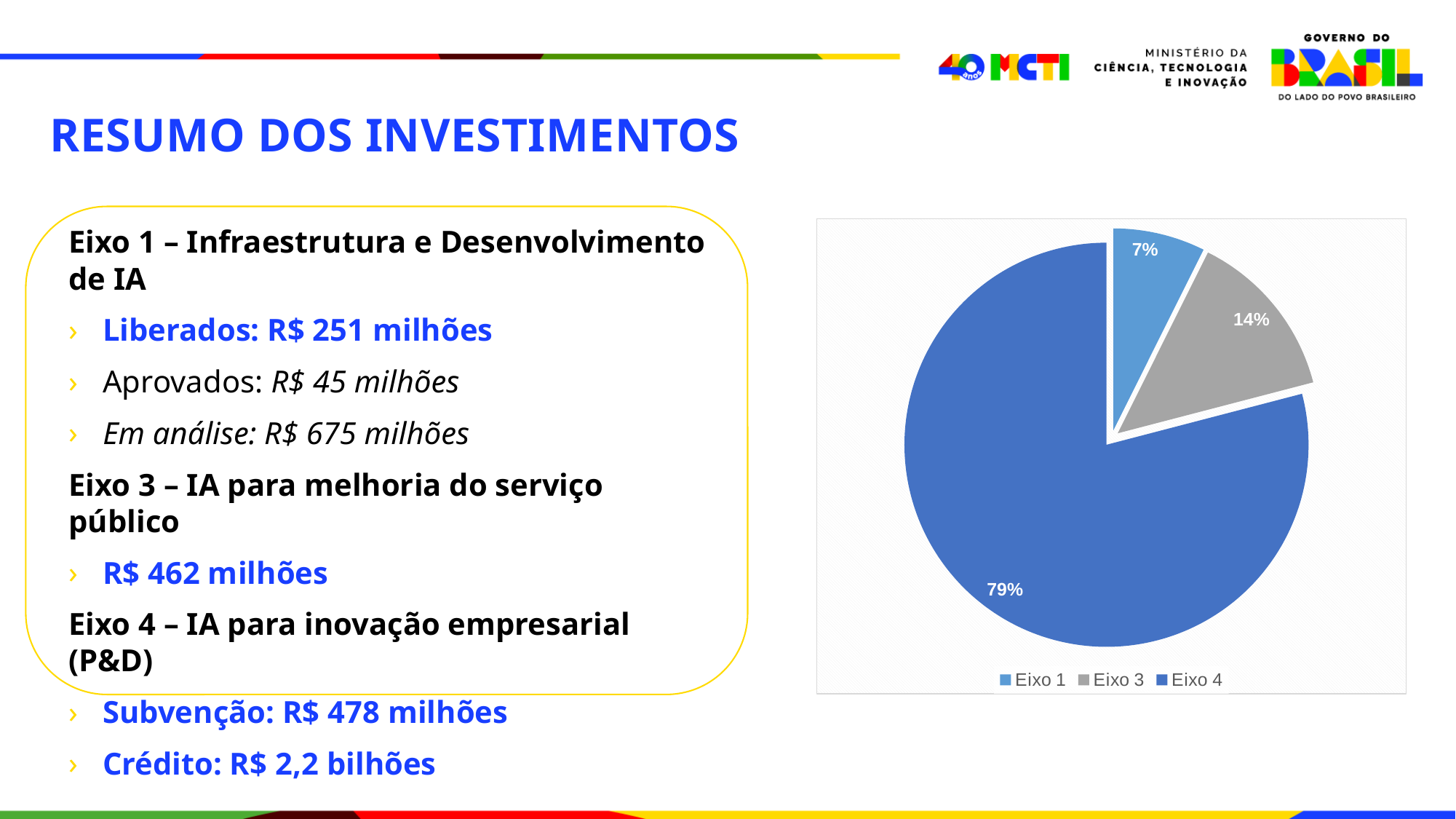
What share of the pie does Eixo 3 represent? 14% Where is the legend positioned in the pie chart? at the bottom Which slice of the pie chart is the smallest? Eixo 1 What colour is the Eixo 3 slice in the pie chart? grey How many entries does the legend of the pie chart list? 3 What is the difference in percentage points between the Eixo 4 slice and the Eixo 3 slice? 65 What share of the pie does Eixo 4 represent? 79% Which slice is larger, Eixo 3 or Eixo 1? Eixo 3 What kind of chart is shown on the slide? pie chart How many slices does the pie chart have? 3 What share of the pie does Eixo 1 represent? 7% Which slice of the pie chart is the largest? Eixo 4